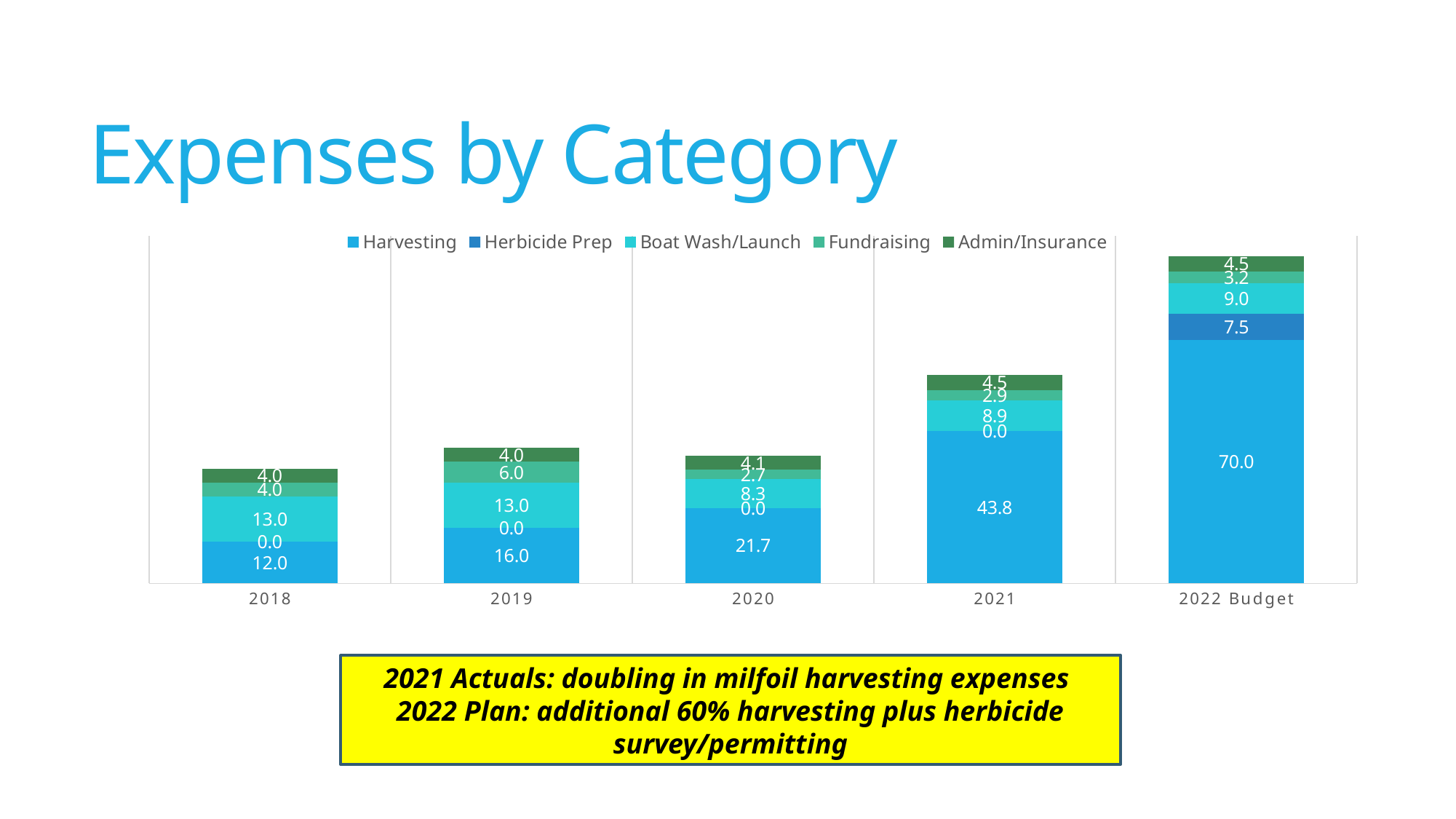
What is the total of the stacked bar for 2022 Budget? 94.2 Which year has the highest Harvesting value? 2022 Budget Which year has the lowest Harvesting value? 2018 What is the Fundraising value for 2019? 6.0 What is the Boat Wash/Launch value for 2020? 8.3 How many categories are shown on the x axis? 5 What is the Herbicide Prep value for 2022 Budget? 7.5 Which is larger, the Boat Wash/Launch value for 2018 or for 2021? 2018 How many series does the legend list? 5 What kind of chart is shown on the slide? Stacked bar chart What is the Harvesting value for 2021? 43.8 What is the difference between the Harvesting values for 2022 Budget and 2021? 26.2